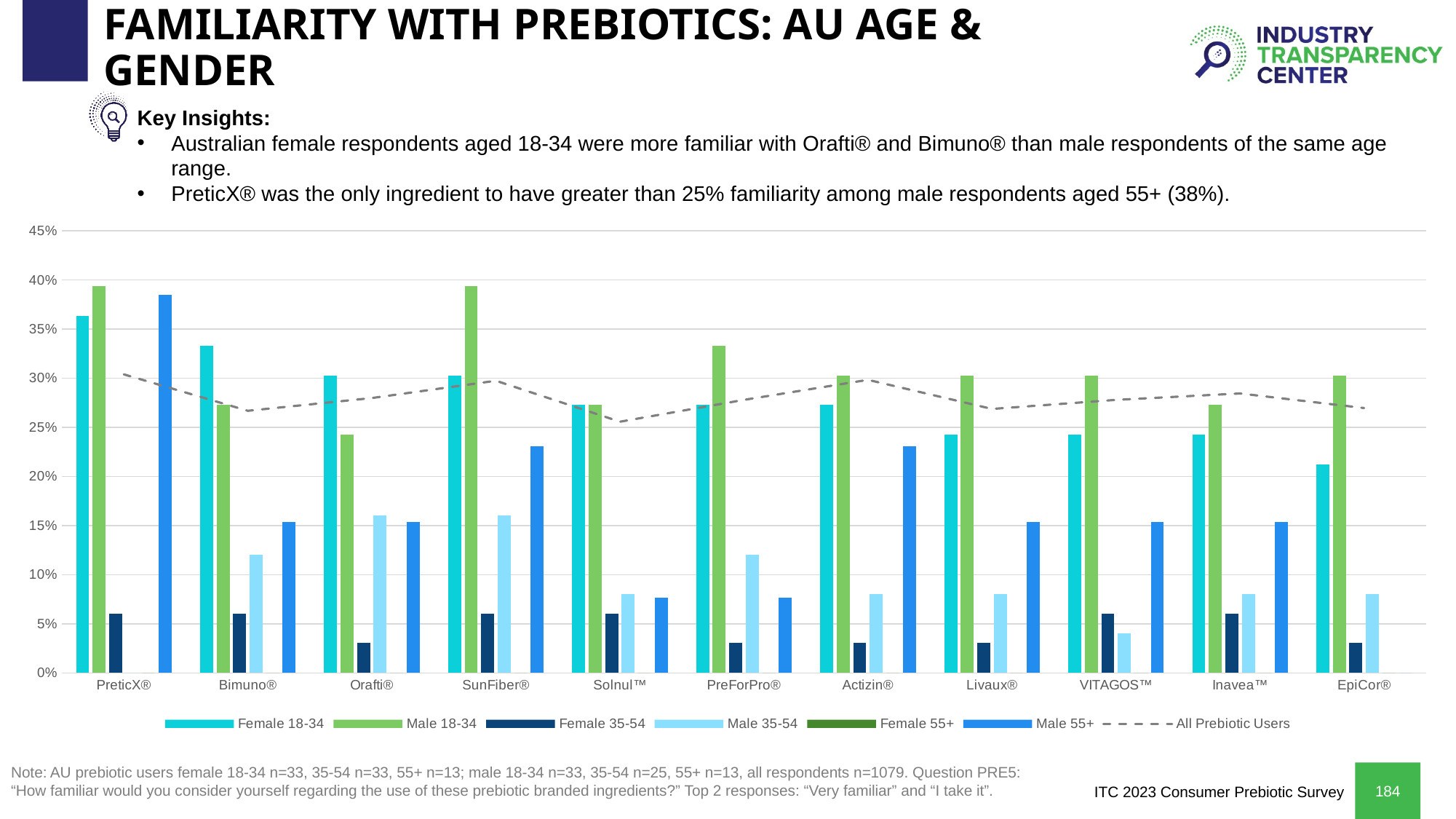
Which series is drawn as a dashed line rather than bars? All Prebiotic Users Among the Female 18-34 bars, which ingredient has the highest value? PreticX® For Bimuno®, which series has the highest value? Female 18-34 Is the Male 18-34 value for SunFiber® greater or less than 35%? greater Is the Female 18-34 value for EpiCor® greater or less than 25%? less How many prebiotic ingredients (categories) are shown on the x axis? 11 What kind of chart is shown on the slide? combination bar and line chart For Orafti®, which is larger: the Female 18-34 value or the Male 18-34 value? Female 18-34 What is the familiarity value for PreticX® among Male 55+ respondents? 38% Is the Male 55+ value for Actizin® greater or less than 25%? less How many series does the legend list? 7